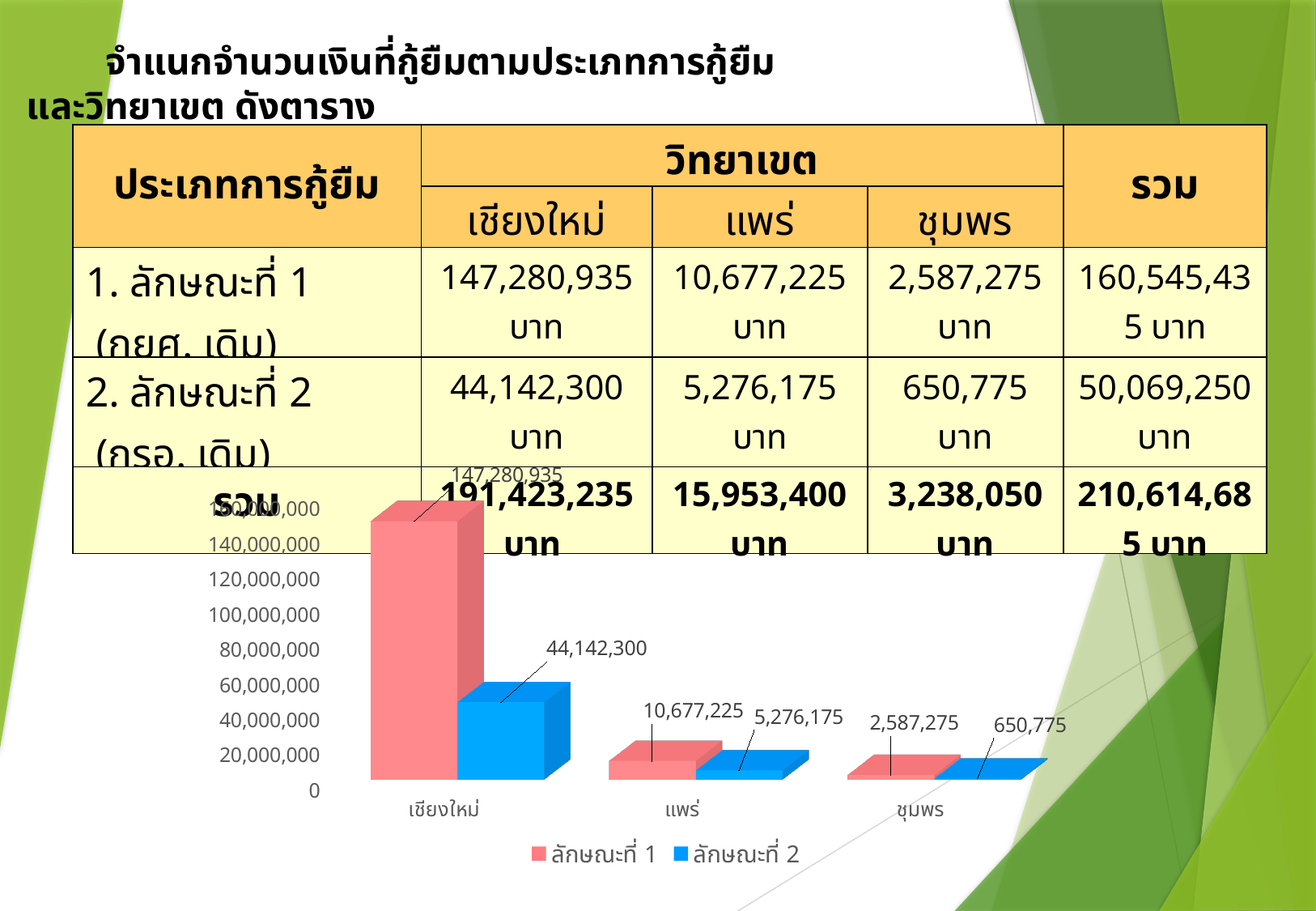
What is the value for ลักษณะที่ 1 at เชียงใหม่ in the chart? 147,280,935 What is the value for ลักษณะที่ 2 at เชียงใหม่ in the chart? 44,142,300 What kind of chart is shown on the slide? bar chart What is the value for ลักษณะที่ 1 at แพร่ in the chart? 10,677,225 How many series does the chart legend list? 2 Which colour represents ลักษณะที่ 2 in the chart legend? blue What is the difference between ลักษณะที่ 1 and ลักษณะที่ 2 at แพร่ in the chart? 5,401,050 How many categories are shown on the x axis of the chart? 3 Which category has the lowest value for ลักษณะที่ 2 in the chart? ชุมพร Which category has the highest value for ลักษณะที่ 1 in the chart? เชียงใหม่ Which is larger in the chart: ลักษณะที่ 2 at เชียงใหม่ or ลักษณะที่ 1 at แพร่? ลักษณะที่ 2 at เชียงใหม่ What is the value for ลักษณะที่ 2 at ชุมพร in the chart? 650,775